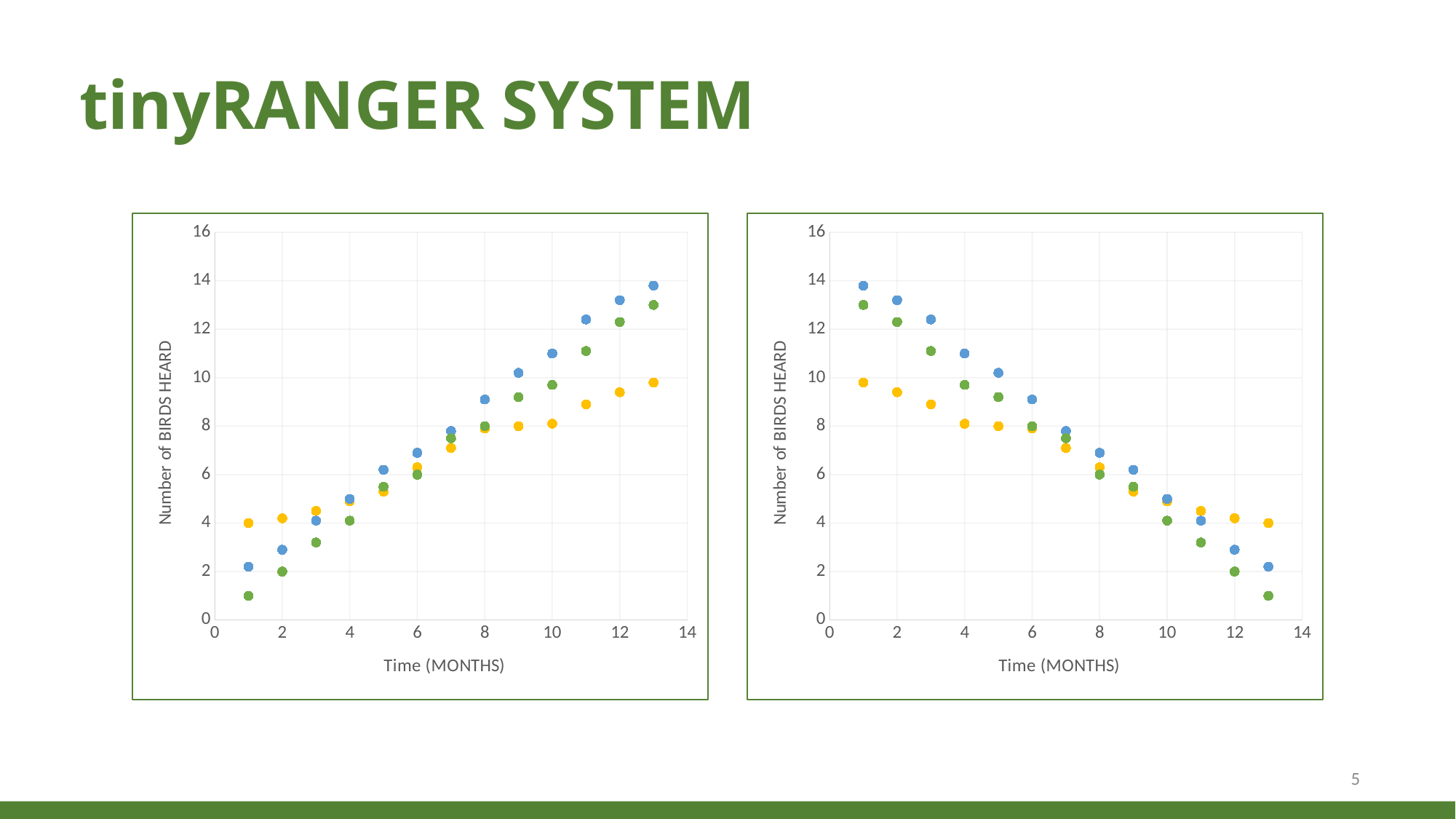
In the chart on the left, is the value of the blue point at month 13 greater or less than 12? greater In the chart on the left, is the value of the green point at month 1 greater or less than 2? less In the chart on the right, do the values rise or fall as time in months increases? fall In the chart on the right, is the value of the green point at month 13 greater or less than 2? less In the chart on the left, do the values rise or fall as time in months increases? rise What kind of chart is the chart on the right of the slide? scatter chart In the chart on the left, at month 13, which is larger: the blue point or the yellow point? the blue point What is the title of the vertical axis in the chart on the left? Number of BIRDS HEARD In the chart on the left, how many points does the blue series have? 13 What kind of chart is the chart on the left of the slide? scatter chart